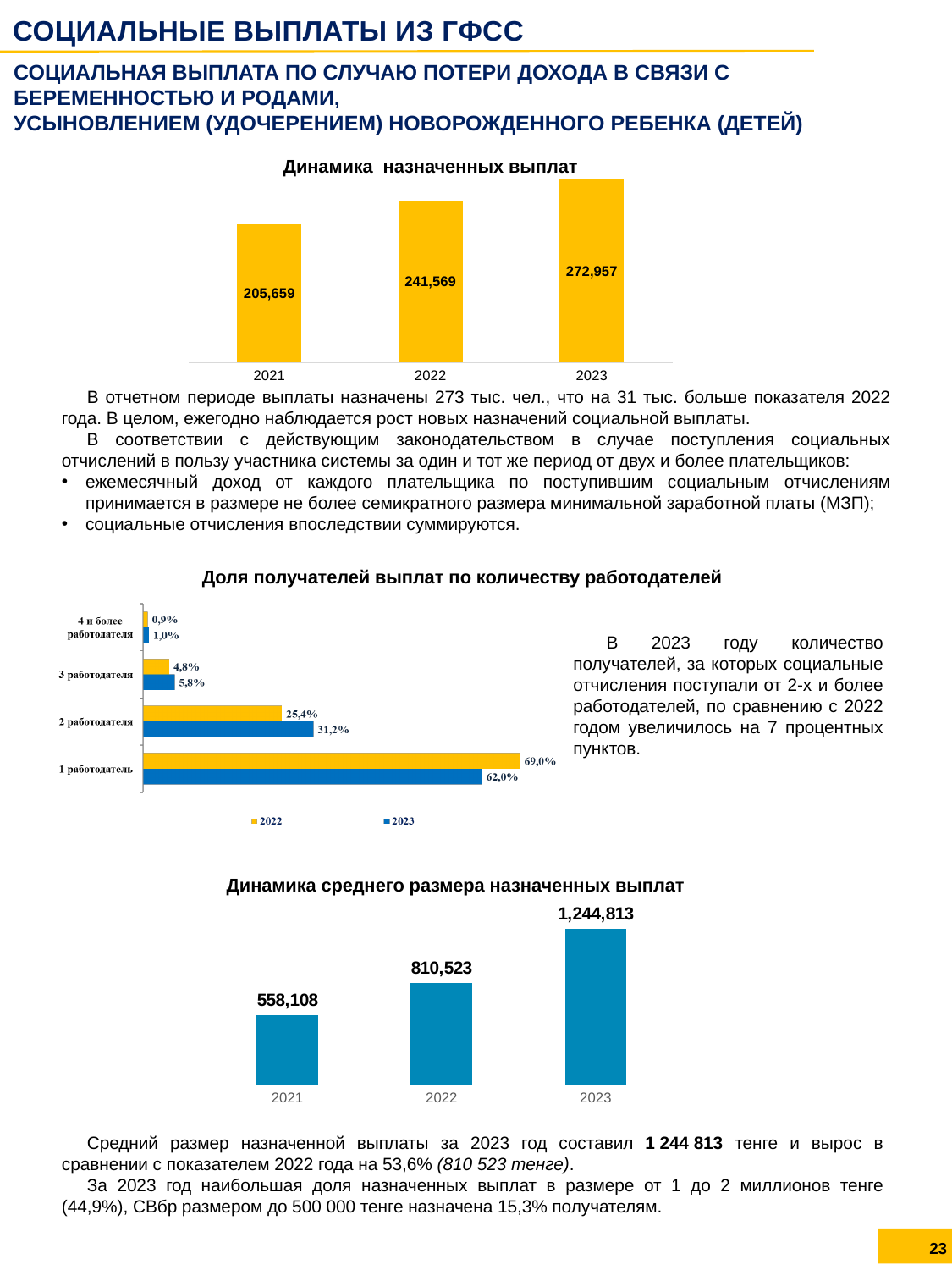
In the chart 'Динамика среднего размера назначенных выплат', how many years are shown? 3 In the chart 'Доля получателей выплат по количеству работодателей', which is larger for '3 работодателя': the 2022 value or the 2023 value? 2023 In the chart 'Динамика среднего размера назначенных выплат', what is the value for 2021? 558,108 In the chart 'Доля получателей выплат по количеству работодателей', what is the 2023 value for '2 работодателя'? 31,2% In the chart 'Динамика назначенных выплат', do the values rise or fall from 2021 to 2023? rise In the chart 'Динамика среднего размера назначенных выплат', which year has the lowest value? 2021 In the chart 'Доля получателей выплат по количеству работодателей', what is the 2022 value for '1 работодатель'? 69,0% In the chart 'Доля получателей выплат по количеству работодателей', how many series does the legend list? 2 In the chart 'Доля получателей выплат по количеству работодателей', what kind of chart is it? bar chart In the chart 'Динамика назначенных выплат', what is the value for 2022? 241,569 In the chart 'Динамика назначенных выплат', what is the difference between the 2023 and 2022 values? 31,388 In the chart 'Динамика назначенных выплат', which year has the highest value? 2023